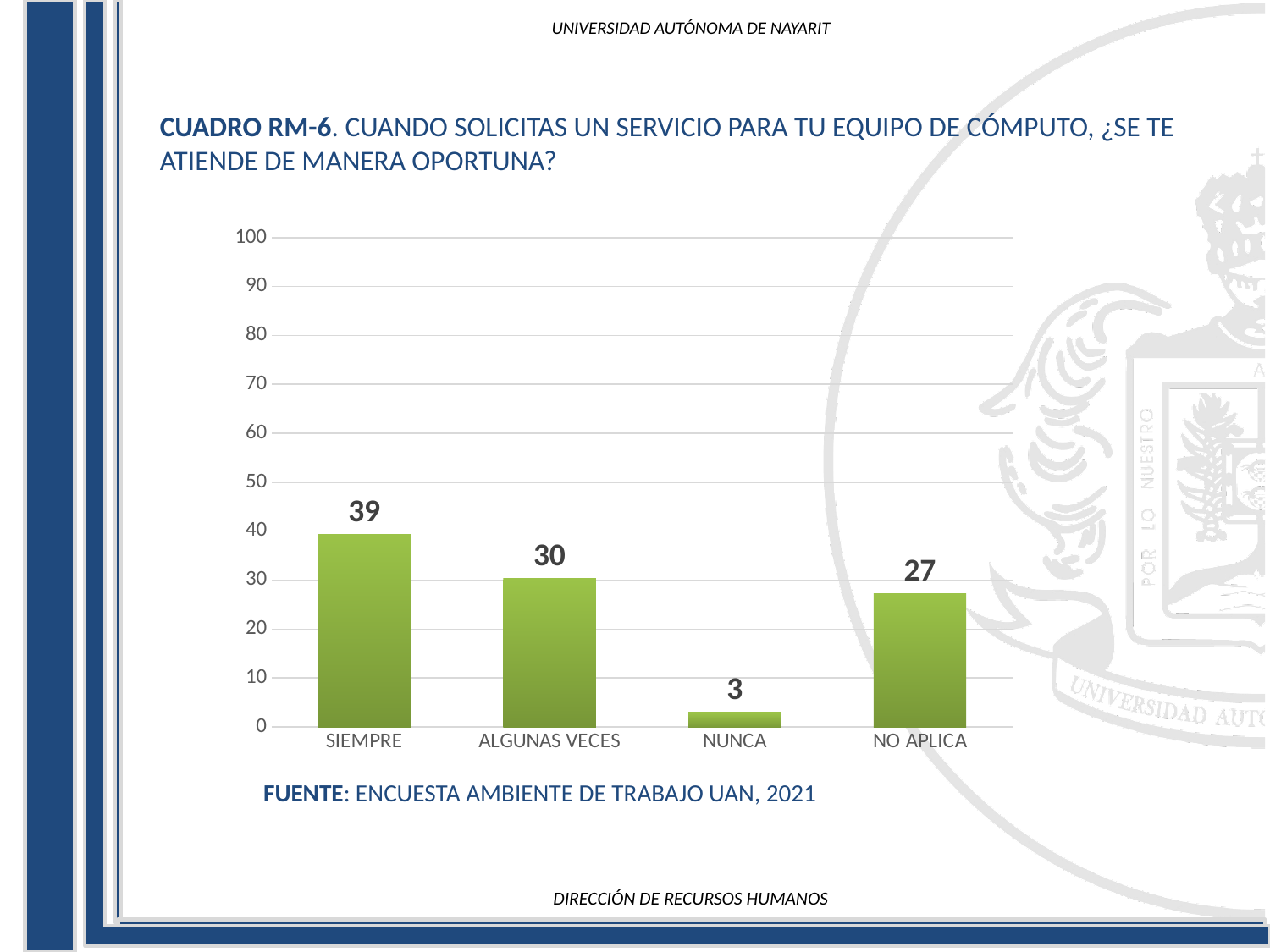
What is the source cited below the chart? ENCUESTA AMBIENTE DE TRABAJO UAN, 2021 What is the value for SIEMPRE? 39 Which category has the highest value? SIEMPRE What is the difference between the values for ALGUNAS VECES and NO APLICA? 3 What is the value for NUNCA? 3 What is the value for NO APLICA? 27 What kind of chart is shown on the slide? bar chart How many categories are shown on the x axis? 4 Which is larger, the value for NO APLICA or the value for NUNCA? NO APLICA What is the value for ALGUNAS VECES? 30 Which category has the lowest value? NUNCA What is the difference between the values for SIEMPRE and ALGUNAS VECES? 9